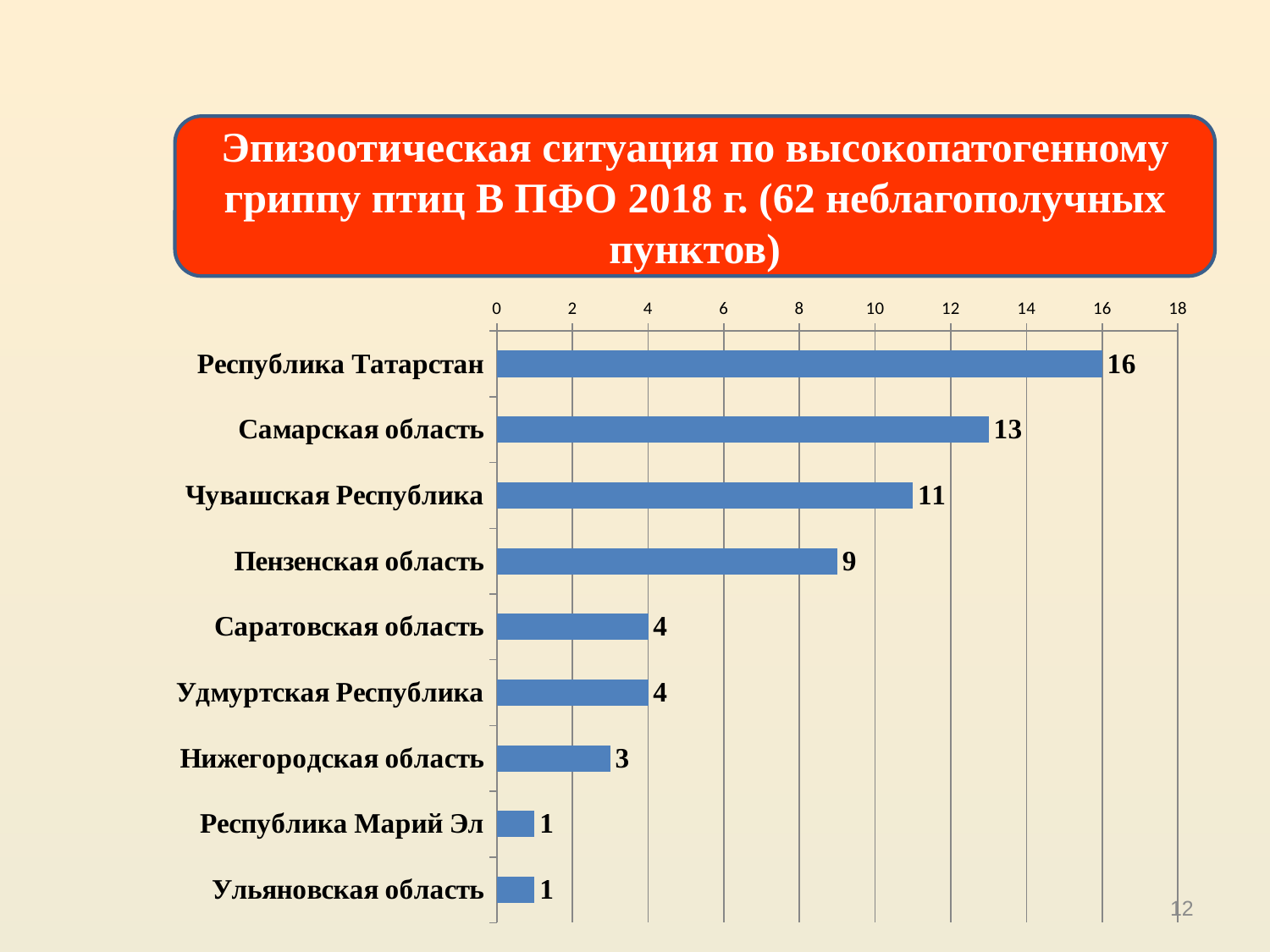
What is the value for Республика Татарстан? 16 What is the highest tick value shown on the value axis? 18 What is the value for Нижегородская область? 3 Is the value for Самарская область greater or less than 12? greater What kind of chart is shown on the slide? bar chart What is the value for Чувашская Республика? 11 What is the difference between the values for Самарская область and Пензенская область? 4 Which is larger, the value for Саратовская область or the value for Нижегородская область? Саратовская область What is the value for Удмуртская Республика? 4 Which category has the highest value? Республика Татарстан How many categories are shown in the chart? 9 What is the difference between the values for Республика Татарстан and Ульяновская область? 15